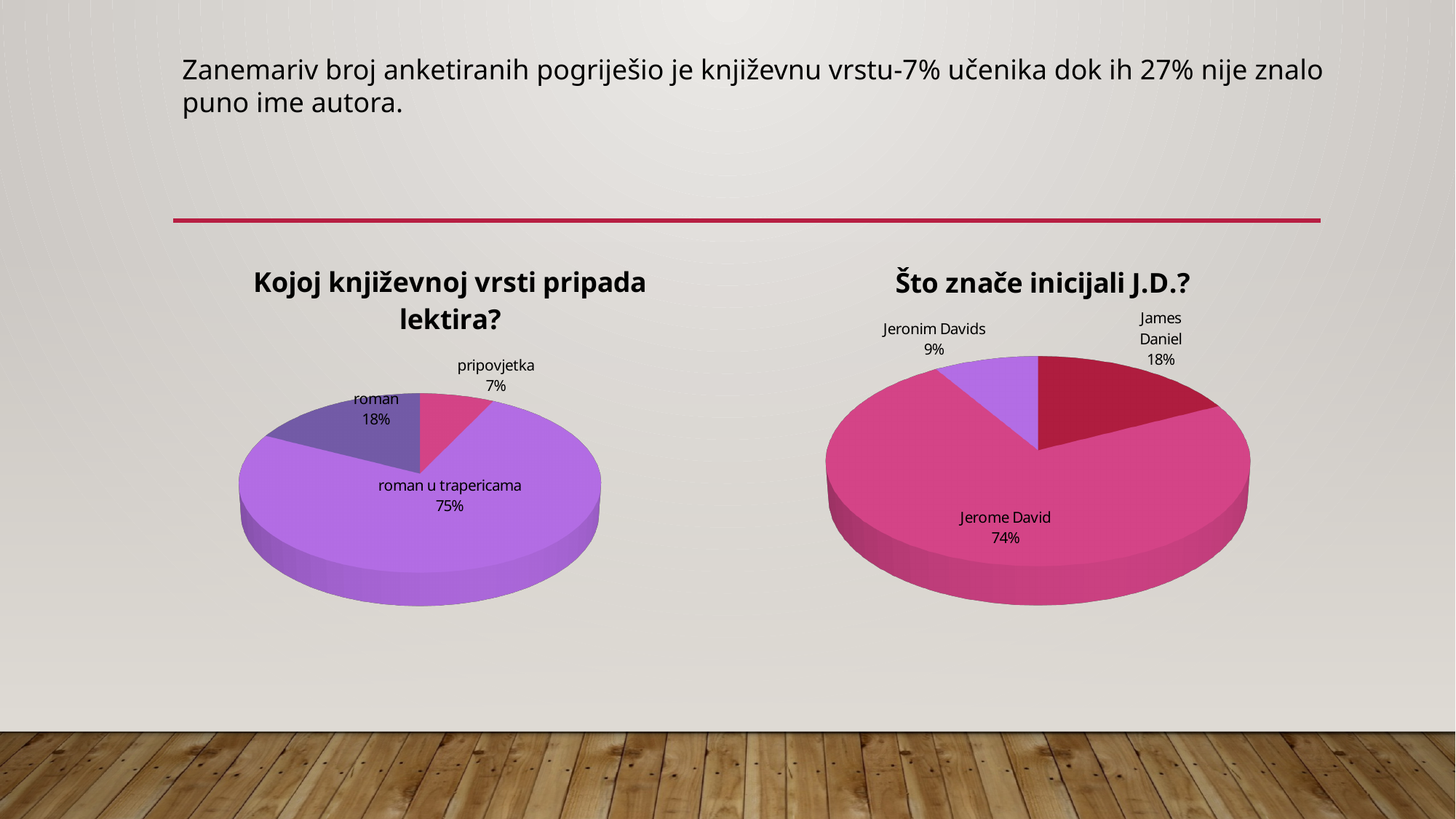
What kind of chart is the chart titled "Što znače inicijali J.D.?"? pie chart In the chart titled "Kojoj književnoj vrsti pripada lektira?", what share does "roman u trapericama" have? 75% In the chart titled "Što znače inicijali J.D.?", what is the difference between the shares of "Jerome David" and "James Daniel"? 56% In the chart titled "Kojoj književnoj vrsti pripada lektira?", which category has the smallest slice? pripovjetka In the chart titled "Što znače inicijali J.D.?", which is larger, "James Daniel" or "Jeronim Davids"? James Daniel In the chart titled "Što znače inicijali J.D.?", which category has the smallest slice? Jeronim Davids In the chart titled "Kojoj književnoj vrsti pripada lektira?", what share does "pripovjetka" have? 7% In the chart titled "Kojoj književnoj vrsti pripada lektira?", how many categories are shown? 3 In the chart titled "Kojoj književnoj vrsti pripada lektira?", which category has the largest slice? roman u trapericama In the chart titled "Kojoj književnoj vrsti pripada lektira?", what is the difference between the shares of "roman" and "pripovjetka"? 11% In the chart titled "Što znače inicijali J.D.?", what share does "Jeronim Davids" have? 9% In the chart titled "Što znače inicijali J.D.?", what share does "Jerome David" have? 74%